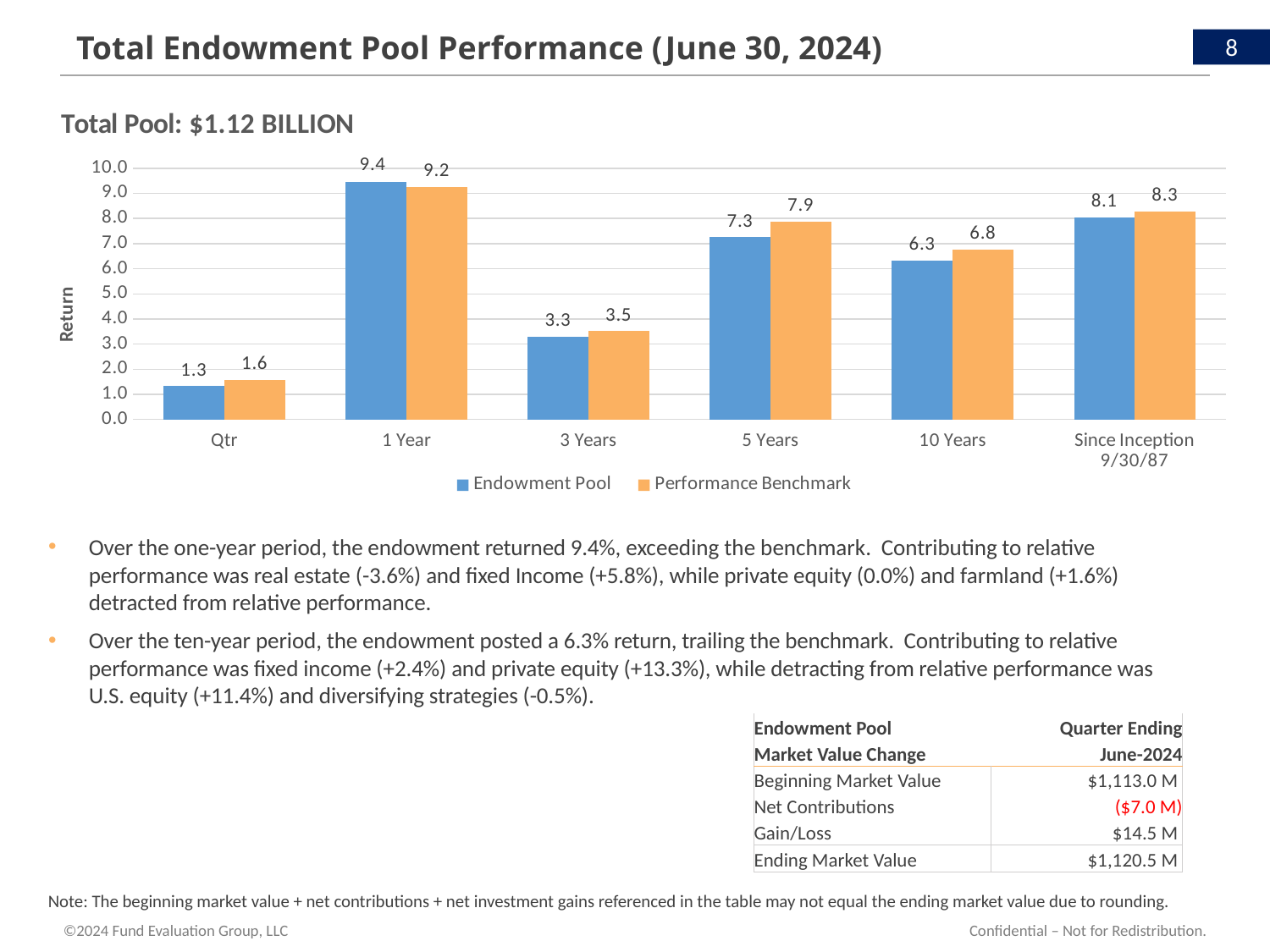
For the 3 Years period, which is larger: the Endowment Pool return or the Performance Benchmark return? Performance Benchmark What is the label of the y axis of the chart? Return How many time periods are shown on the x axis of the chart? 6 Which period has the highest Endowment Pool return? 1 Year What is the Endowment Pool return for the Qtr period? 1.3 What kind of chart is shown on the slide? Bar chart What is the Performance Benchmark return for the 10 Years period? 6.8 For the 1 Year period, which is larger: the Endowment Pool return or the Performance Benchmark return? Endowment Pool What is the difference between the Performance Benchmark and Endowment Pool returns for the 5 Years period? 0.6 What is the Endowment Pool return for the 1 Year period? 9.4 How many series does the chart legend list? 2 Which period has the lowest Performance Benchmark return? Qtr